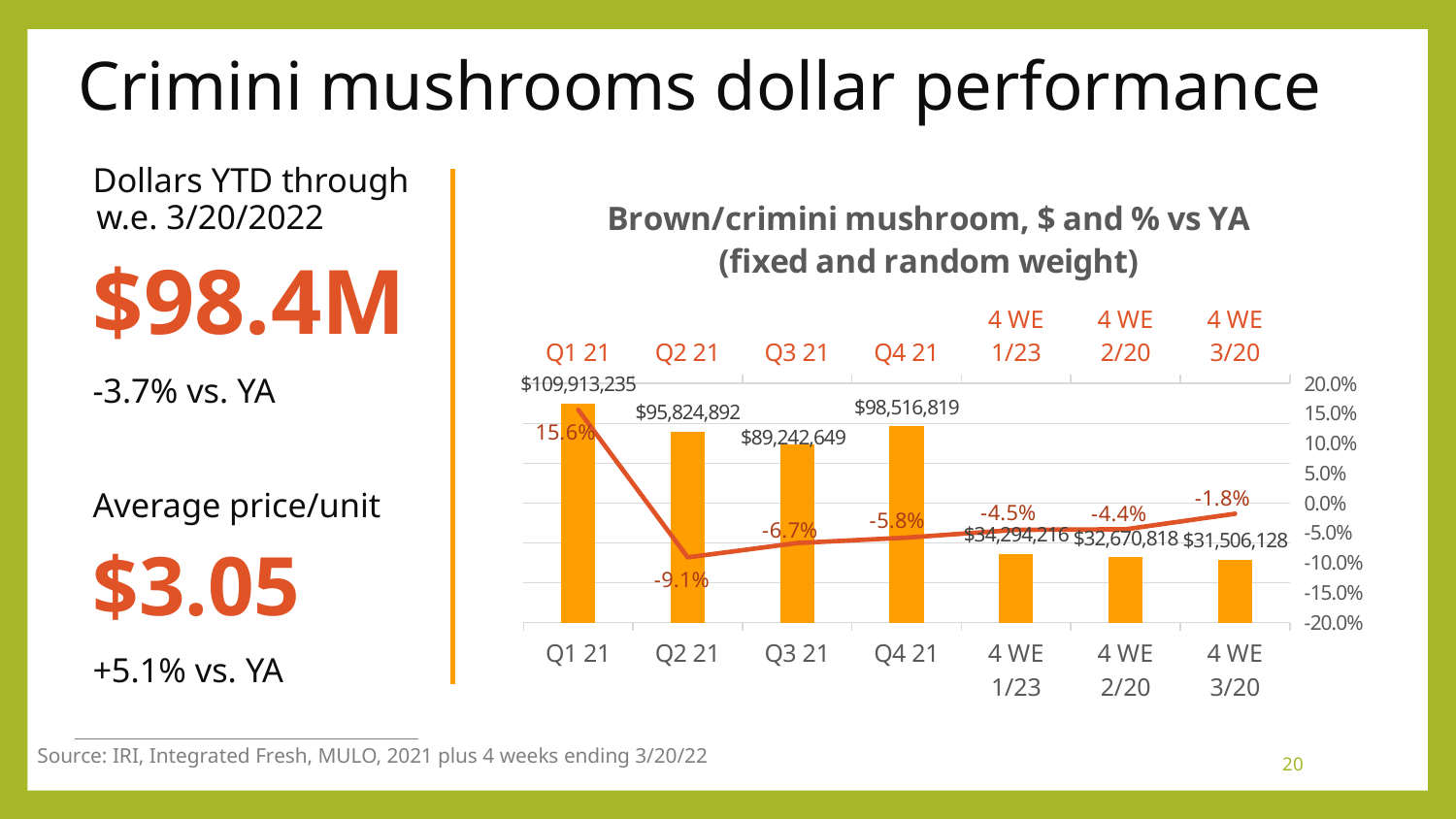
Does the % vs YA line rise or fall from Q2 21 to 4 WE 3/20? Rise What kind of chart is this? Combined bar and line chart What is the % vs YA value for 4 WE 3/20? -1.8% What is the title of the chart? Brown/crimini mushroom, $ and % vs YA (fixed and random weight) How many periods are shown on the x axis? 7 Which has a larger dollar value, Q2 21 or Q4 21? Q4 21 Which period has the highest dollar value? Q1 21 Which period has the lowest % vs YA value? Q2 21 What is the difference in dollar value between Q4 21 and Q3 21? $9,274,170 What is the dollar value for Q1 21? $109,913,235 What is the % vs YA value for Q2 21? -9.1% What is the dollar value for 4 WE 3/20? $31,506,128